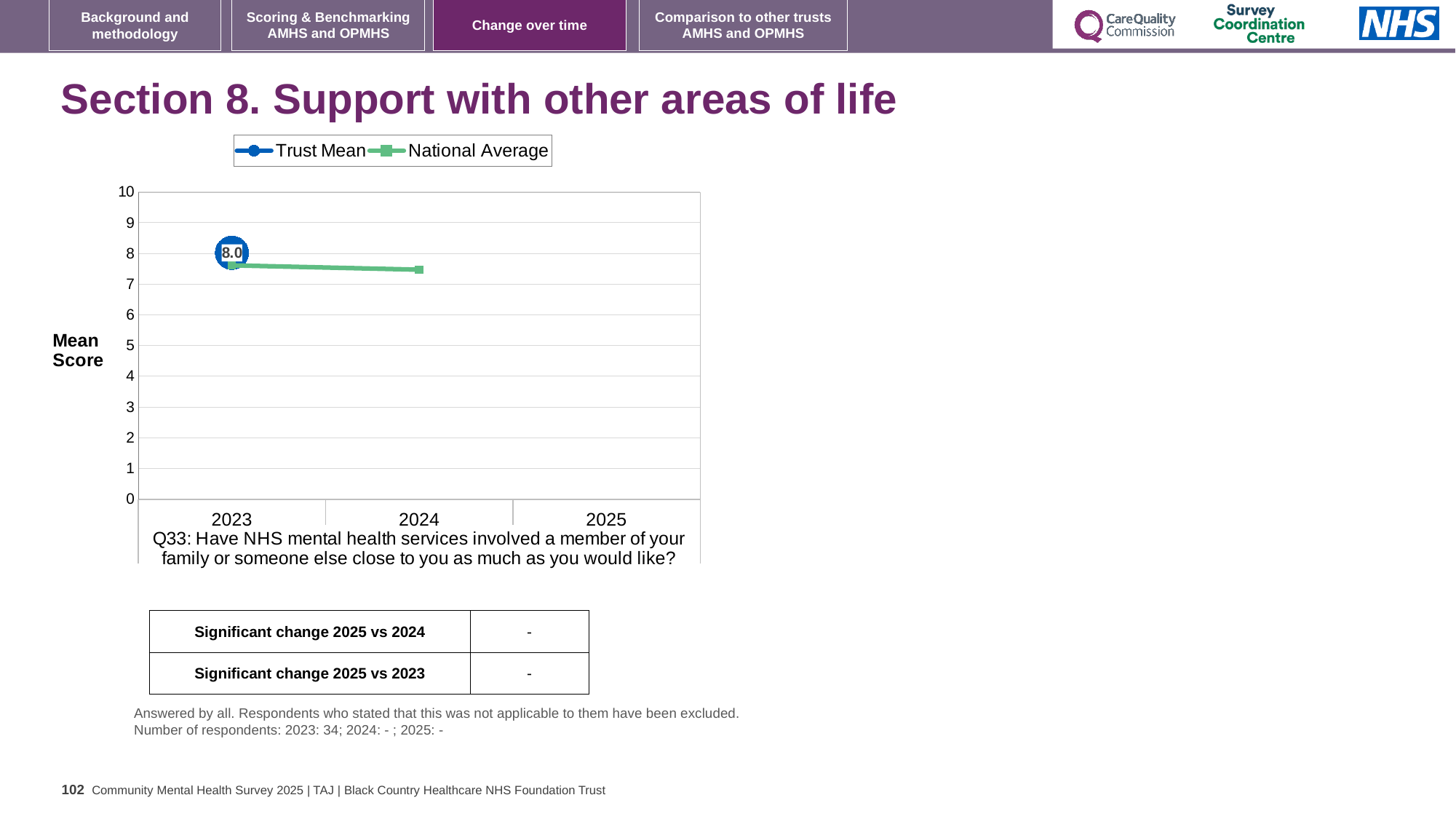
Is the National Average value for 2023 greater or less than 9? less In 2023, which is higher: the Trust Mean or the National Average? Trust Mean Is the Trust Mean value for 2023 greater or less than 7? greater What is the Trust Mean value for 2023? 8.0 What kind of chart is shown on the slide? Line chart How many series does the legend list? 2 What is the label on the y axis of the chart? Mean Score For which year is a Trust Mean data label shown on the chart? 2023 How many years are shown on the x axis? 3 Is the National Average value for 2024 greater or less than 5? greater Does the National Average rise or fall from 2023 to 2024? Fall What are the two series named in the legend? Trust Mean and National Average